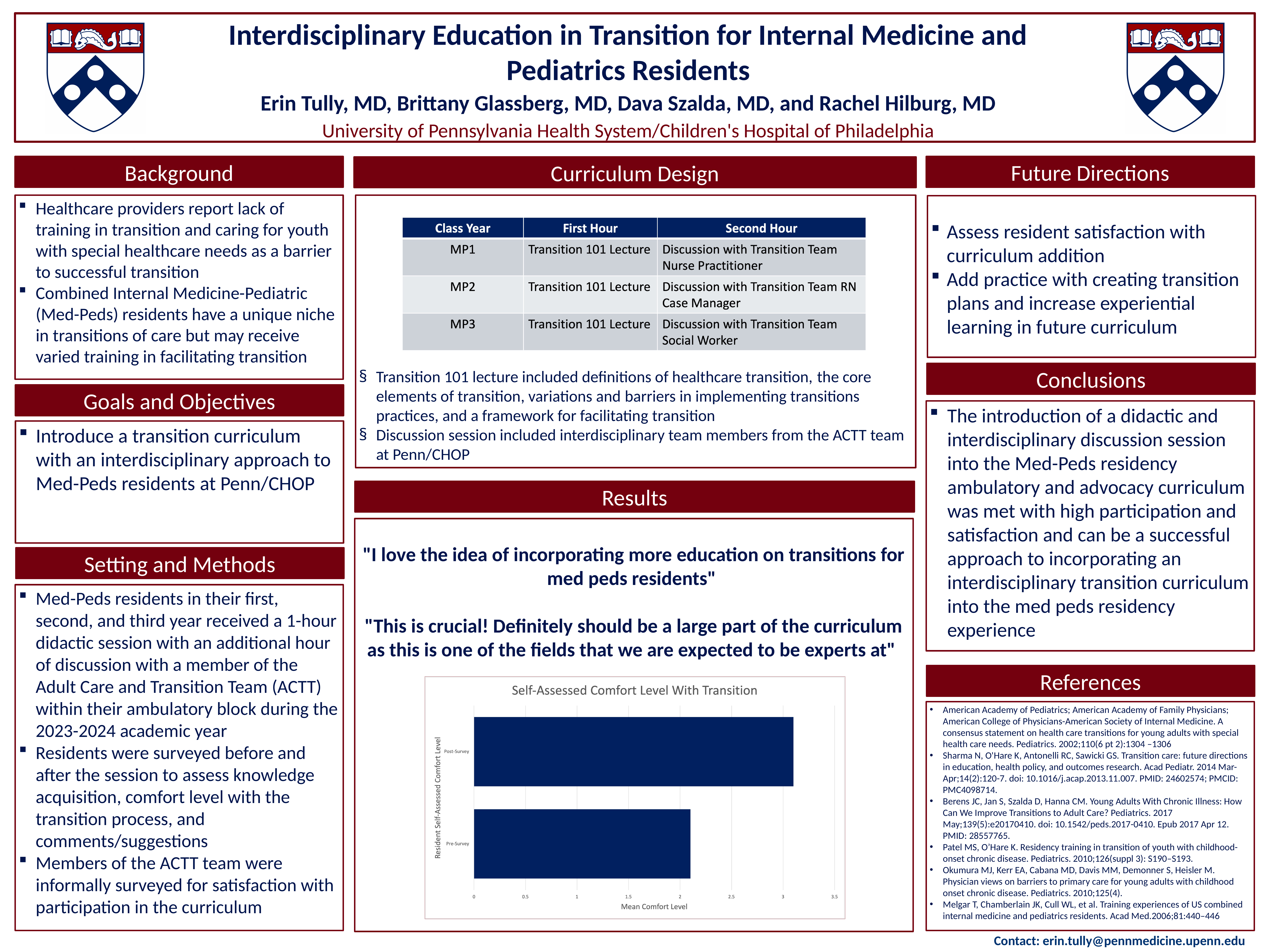
In the Self-Assessed Comfort Level With Transition chart, is the value for Pre-Survey greater or less than 2.5? less In the Self-Assessed Comfort Level With Transition chart, is the value for Post-Survey greater or less than 2.5? greater What is the label of the horizontal axis in the Self-Assessed Comfort Level With Transition chart? Mean Comfort Level In the Self-Assessed Comfort Level With Transition chart, is the value for Pre-Survey greater or less than 1.5? greater What is the title of the chart in the Results section? Self-Assessed Comfort Level With Transition How many categories are plotted in the Self-Assessed Comfort Level With Transition chart? 2 In the Self-Assessed Comfort Level With Transition chart, which category has the lowest mean comfort level? Pre-Survey In the Self-Assessed Comfort Level With Transition chart, which category has the highest mean comfort level? Post-Survey In the Self-Assessed Comfort Level With Transition chart, is the mean comfort level larger for Post-Survey or Pre-Survey? Post-Survey What kind of chart is shown under the Results section? bar chart